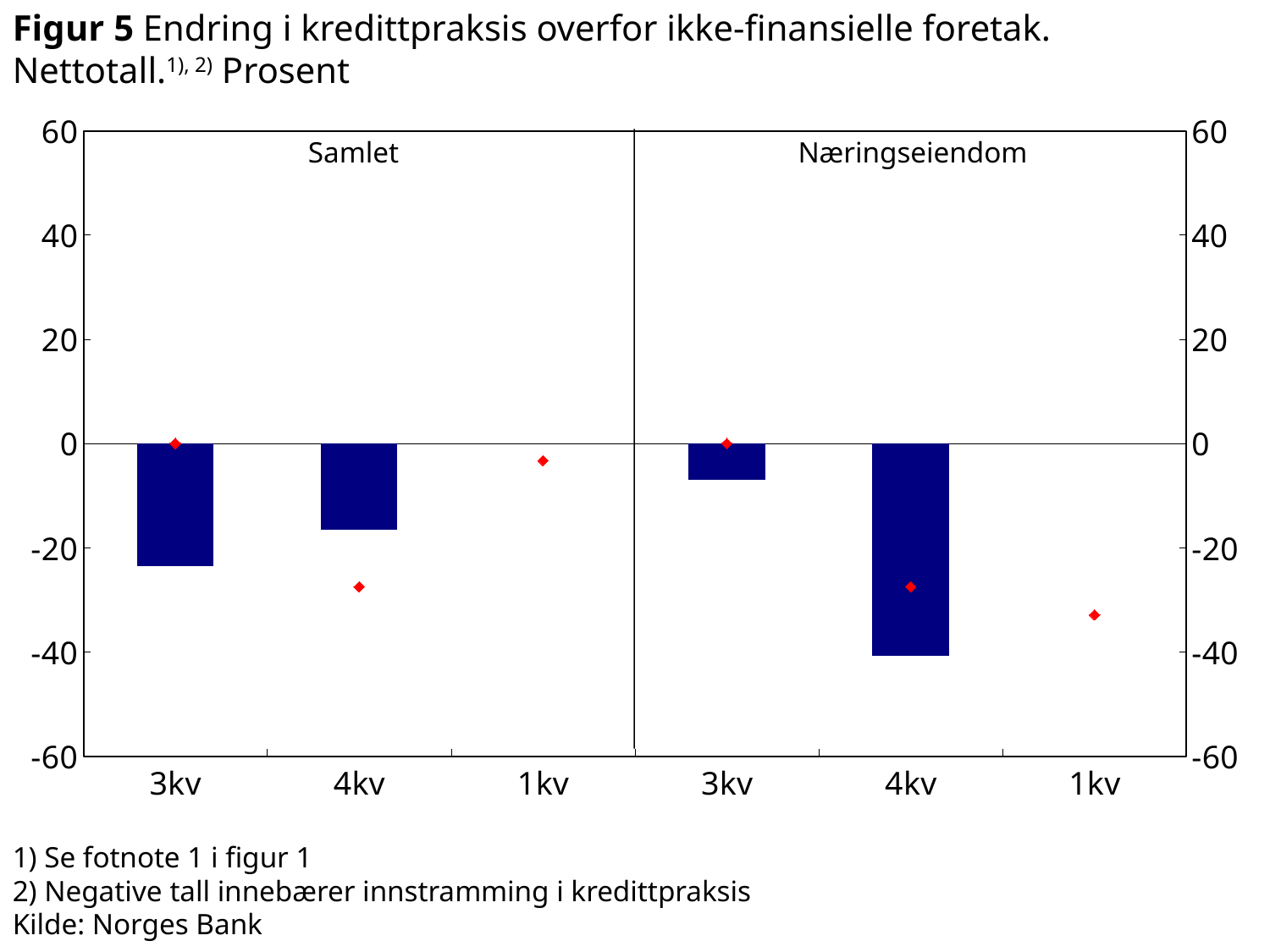
In the Næringseiendom panel, is the bar for 4kv greater or less than -20? less How many quarters are shown on the x axis of each panel? 3 In the Næringseiendom panel, is the bar for 3kv greater or less than -20? greater In the Samlet panel, is the bar for 3kv greater or less than -20? less In the Næringseiendom panel, which quarter has the lowest bar? 4kv What are the names of the two panels in the chart? Samlet and Næringseiendom What is the source given for the chart? Norges Bank What kind of chart is shown in Figur 5? bar chart In the Samlet panel, which quarter has the lower bar, 3kv or 4kv? 3kv Which 4kv bar is lower, the one in the Samlet panel or the one in the Næringseiendom panel? Næringseiendom